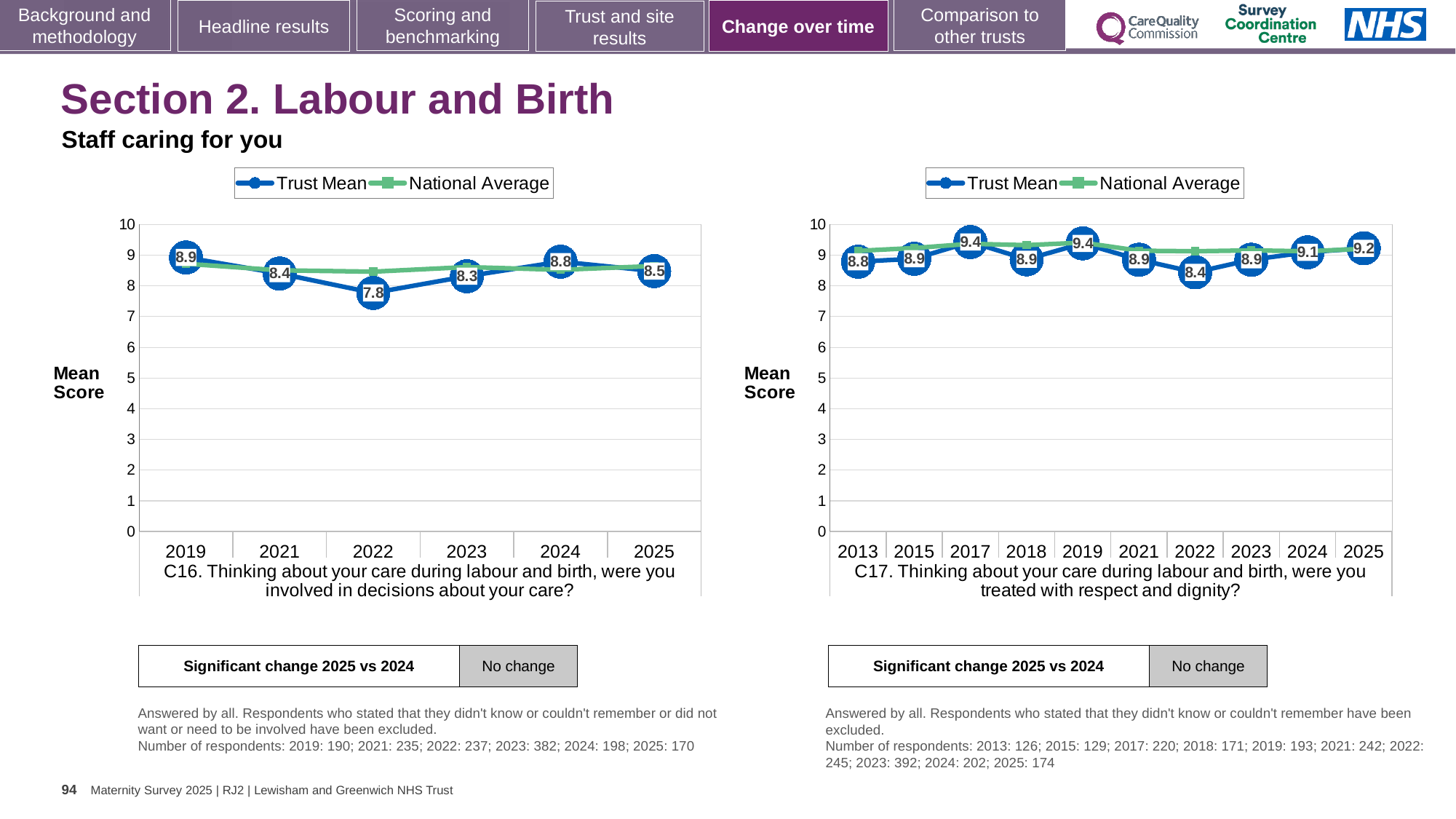
In the C16 chart (left), what is the Trust Mean for 2019? 8.9 In the C17 chart (right), what is the Trust Mean for 2025? 9.2 In the C16 chart (left), what is the Trust Mean for 2022? 7.8 In the C16 chart (left), what is the difference between the Trust Mean for 2024 and 2025? 0.3 In the C16 chart (left), which year has the lowest Trust Mean? 2022 In the C17 chart (right), is the Trust Mean for 2024 or 2025 larger? 2025 In the C17 chart (right), how many series does the legend list? 2 In the C17 chart (right), which year has the lowest Trust Mean? 2022 In the C17 chart (right), what is the Trust Mean for 2022? 8.4 What type of chart is the C16 chart (left)? Line chart In the C16 chart (left), which year has the highest Trust Mean? 2019 In the C16 chart (left), how many years are plotted on the x axis? 6